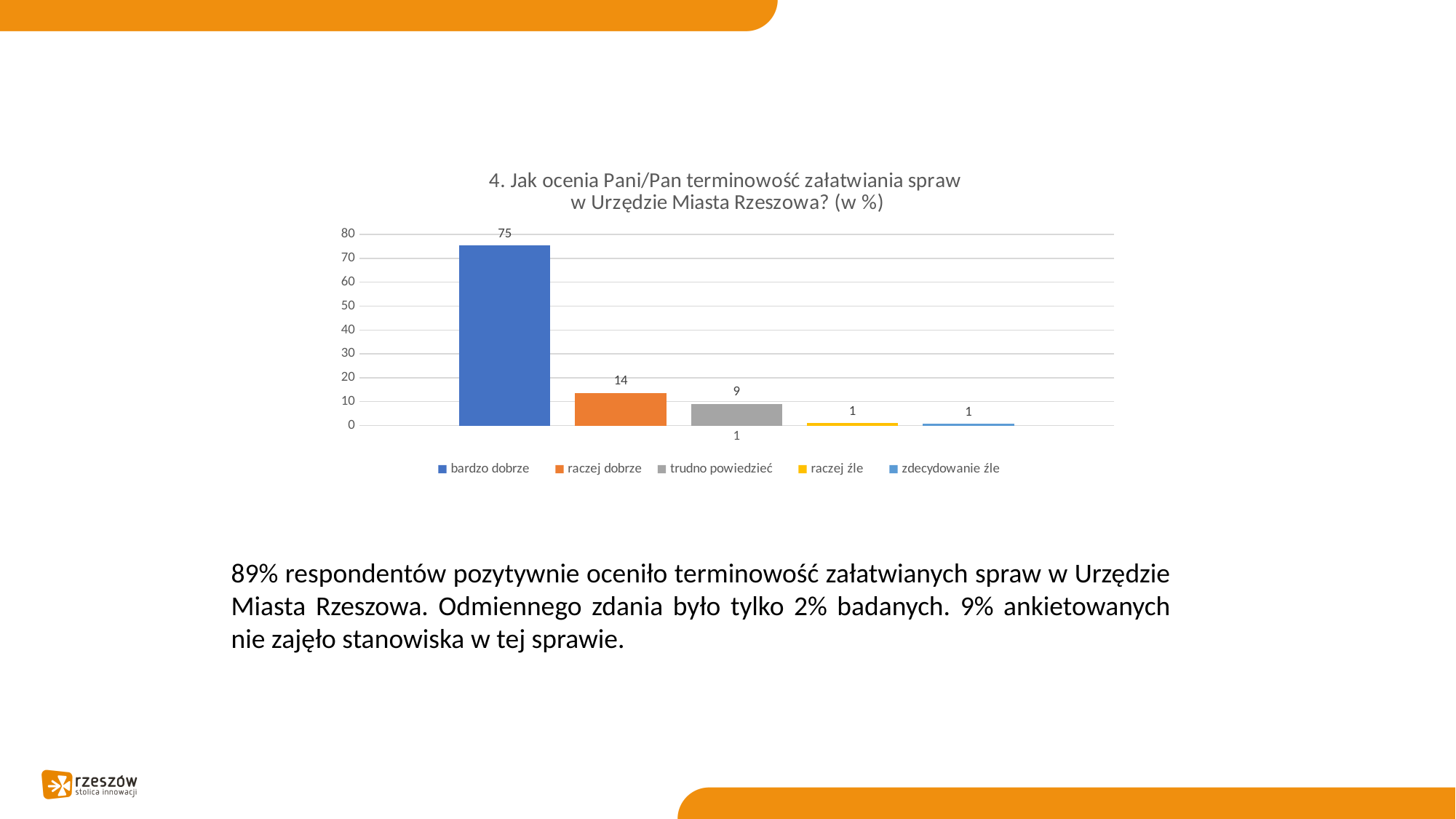
How many series does the legend list? 5 What colour is the bar for "raczej źle"? yellow What is the difference between the values for "bardzo dobrze" and "raczej dobrze"? 61 Which series has the highest value? bardzo dobrze What is the value for "trudno powiedzieć"? 9 What is the value for "raczej źle"? 1 Which is larger, the value for "raczej dobrze" or the value for "trudno powiedzieć"? raczej dobrze What kind of chart is shown on the slide? bar chart What is the difference between the values for "raczej dobrze" and "trudno powiedzieć"? 5 Is the value for "bardzo dobrze" greater or less than 70? greater What is the value for "raczej dobrze"? 14 What is the value for "bardzo dobrze"? 75